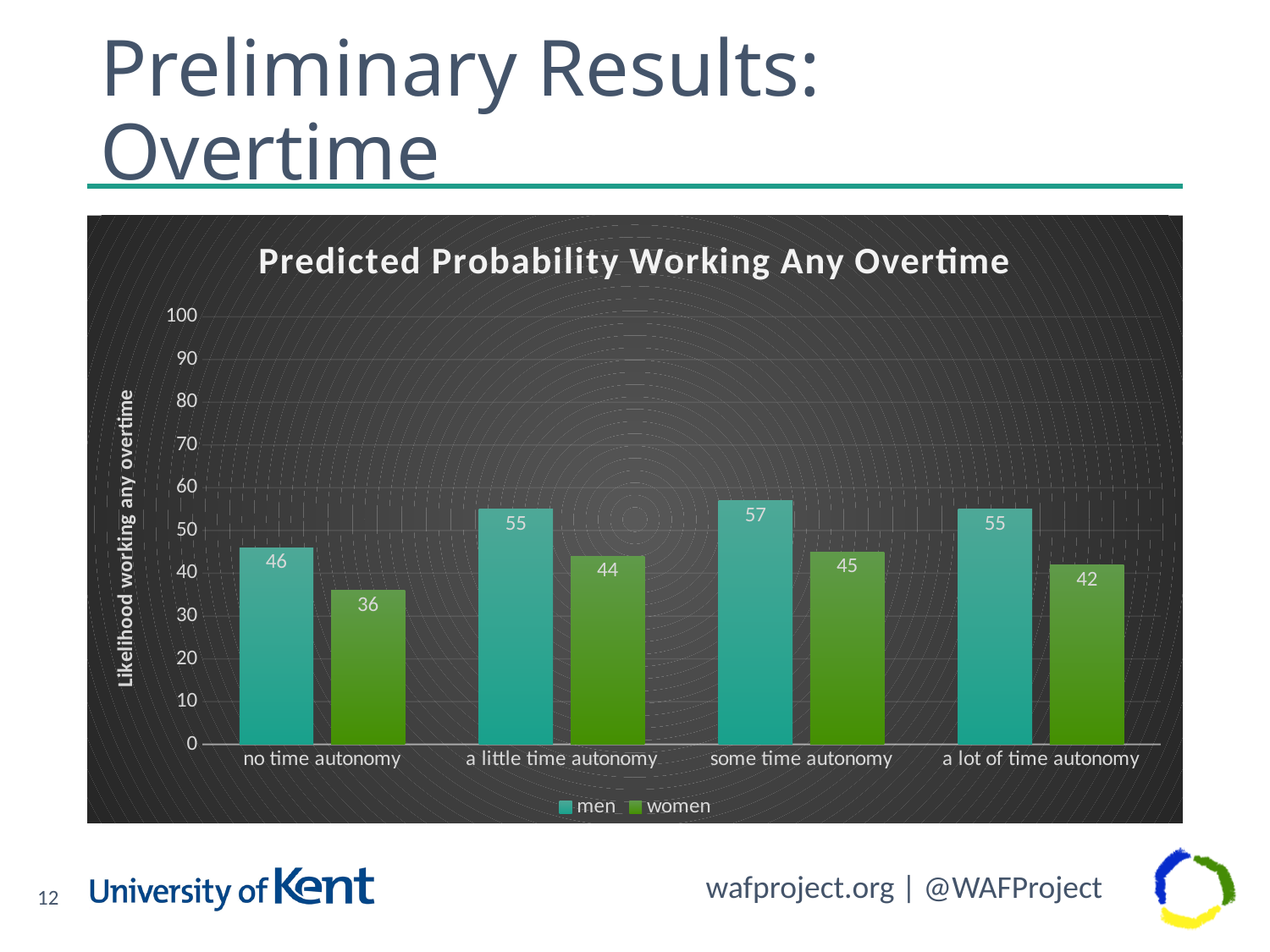
How many series does the legend list? 2 Which category has the lowest value for women? no time autonomy What is the difference between the men and women values in the 'no time autonomy' category? 10 Which is larger: the value for women in 'some time autonomy' or the value for women in 'a lot of time autonomy'? some time autonomy What is the value for women in the 'a little time autonomy' category? 44 Which category has the highest value for men? some time autonomy What is the difference between the men and women values in the 'some time autonomy' category? 12 What is the value for men in the 'no time autonomy' category? 46 What is the title of the chart? Predicted Probability Working Any Overtime What kind of chart is shown on the slide? bar chart How many categories are shown on the x axis? 4 What is the value for women in the 'a lot of time autonomy' category? 42